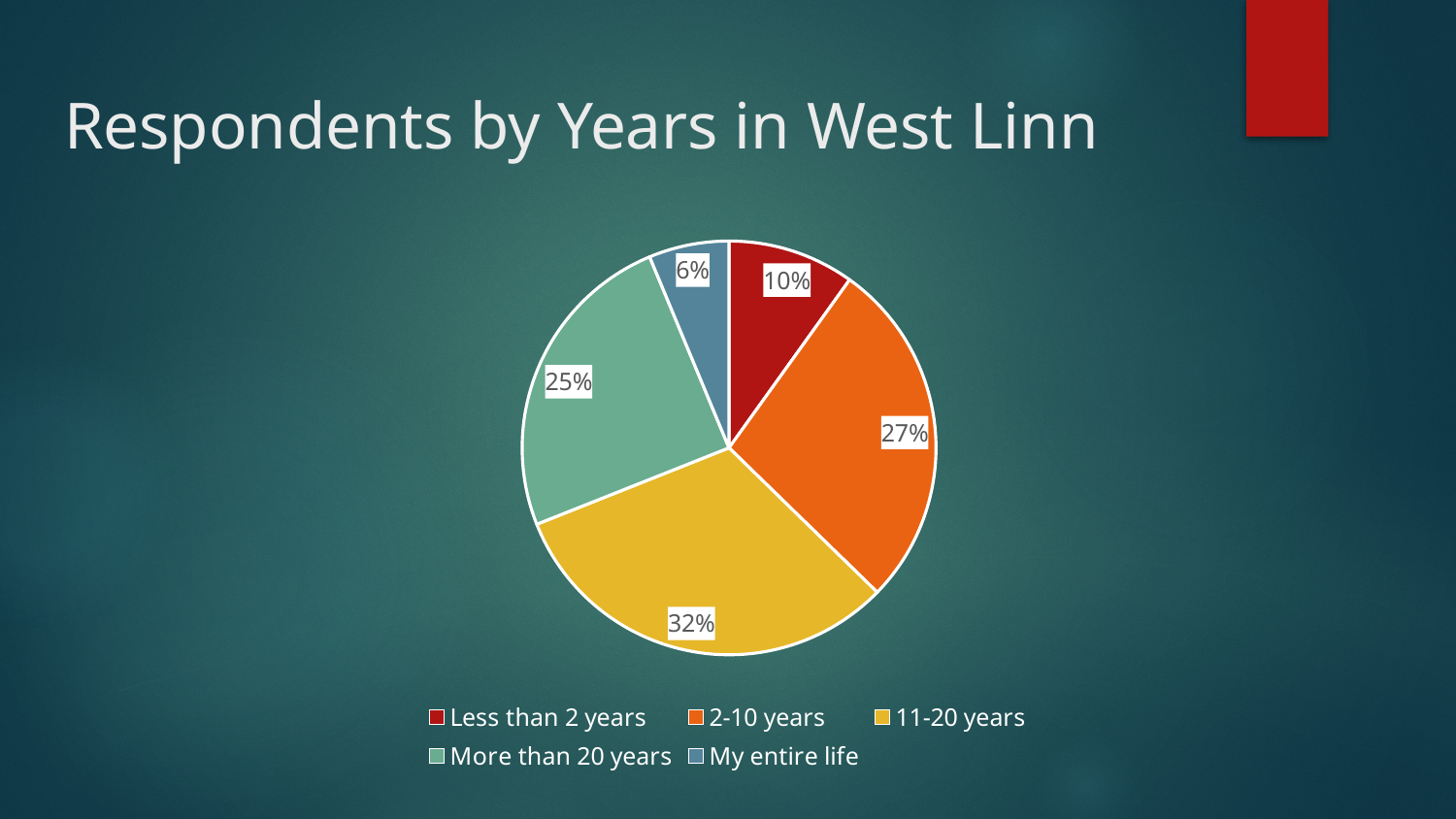
Which category has the largest share of respondents? 11-20 years How many categories does the pie chart show? 5 What percentage of respondents have lived in West Linn for less than 2 years? 10% What percentage of respondents have lived in West Linn their entire life? 6% What kind of chart is shown on the slide? pie chart What colour is the slice for Less than 2 years? red What percentage of respondents have lived in West Linn for 11-20 years? 32% Which is larger: the share for 2-10 years or the share for More than 20 years? 2-10 years What percentage of respondents have lived in West Linn for 2-10 years? 27% Which category has the smallest share of respondents? My entire life What is the difference in percentage points between the 11-20 years slice and the More than 20 years slice? 7 What is the title of the chart? Respondents by Years in West Linn